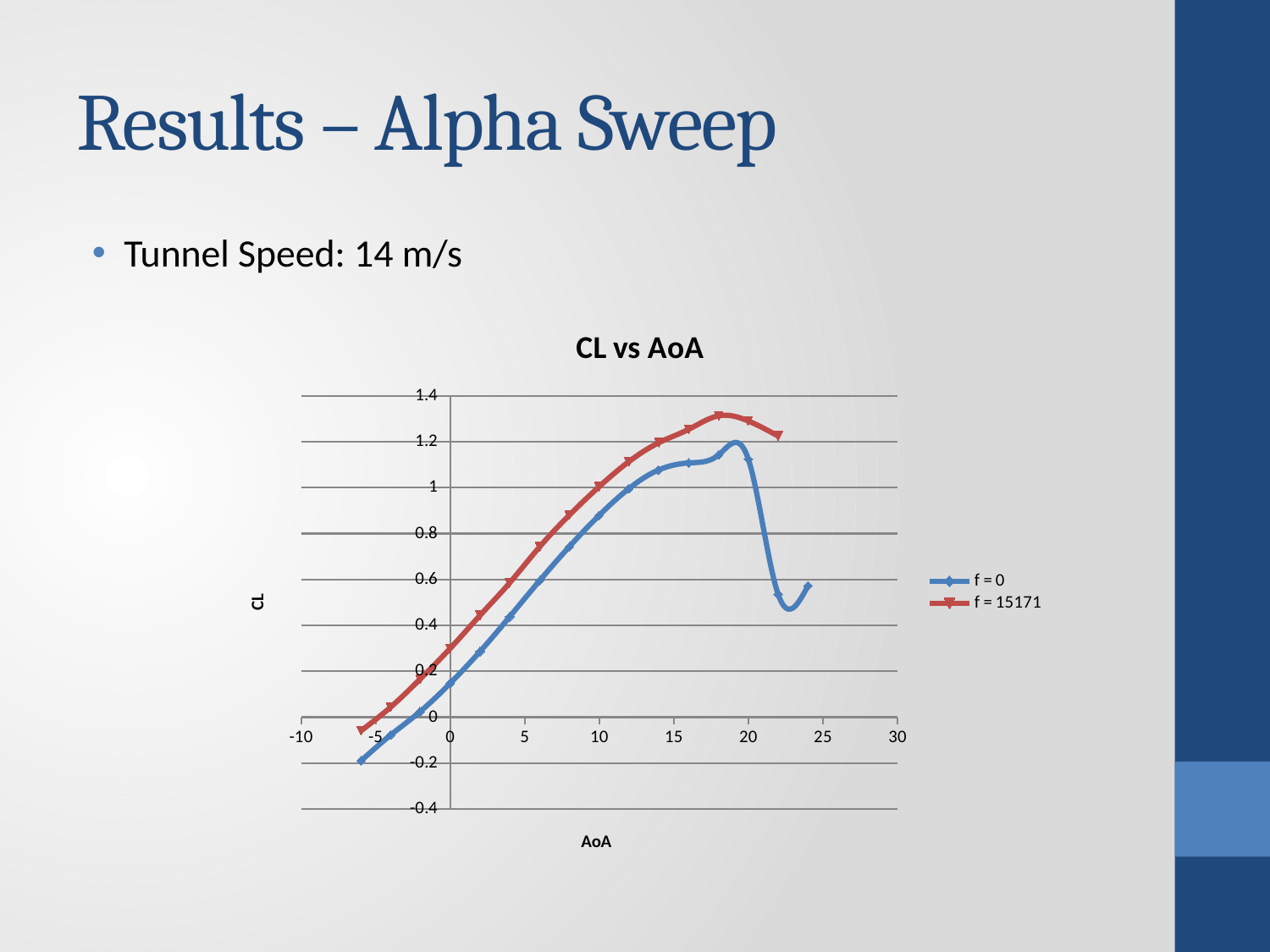
What is the title of the chart? CL vs AoA At AoA 10, which series has the higher CL value, f = 0 or f = 15171? f = 15171 Does the CL value for f = 15171 rise or fall as AoA increases from -5 to 15? rise What kind of chart is shown on the slide? line chart Does the CL value for f = 0 rise or fall as AoA increases from 19 to 22? fall Is the CL value for f = 15171 at AoA 18 greater or less than 1.2? greater Is the CL value for f = 0 at AoA 10 greater or less than 0.8? greater Is the CL value for f = 0 at AoA 22 greater or less than 0.6? less How many series does the legend list? 2 Which series reaches the higher peak CL value? f = 15171 Which series is drawn in red? f = 15171